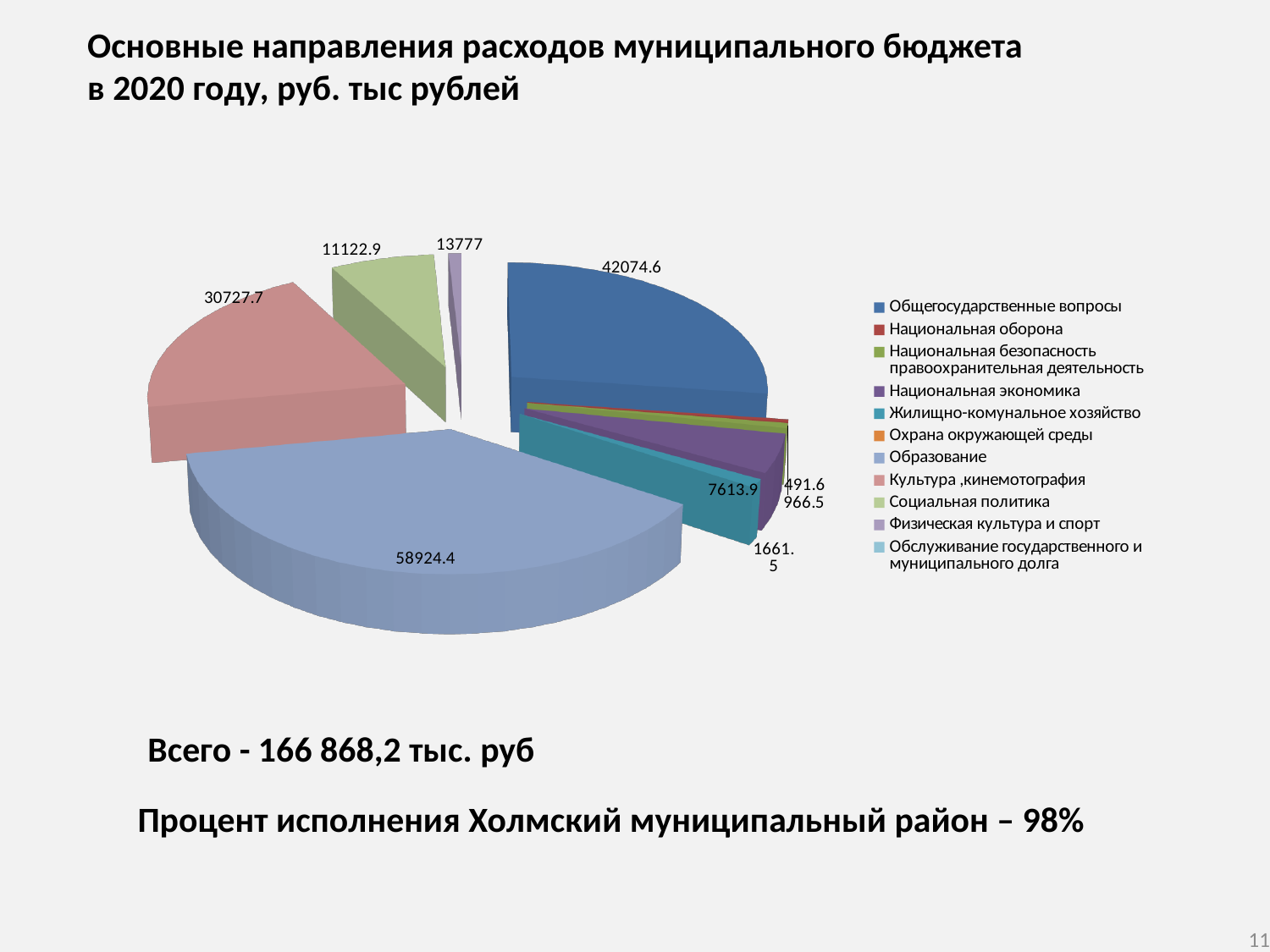
What is the value for Образование? 58924.4 What is the difference between Общегосударственные вопросы and Культура, кинемотография? 11346.9 Which is larger, Образование or Общегосударственные вопросы? Образование What is the value for Общегосударственные вопросы? 42074.6 Which is larger, Культура, кинемотография or Социальная политика? Культура, кинемотография What is the value for Культура, кинемотография? 30727.7 What is the value for Социальная политика? 11122.9 What type of chart is shown on the slide? Pie chart What is the difference between Образование and Общегосударственные вопросы? 16849.8 How many categories does the legend list? 11 Which category has the largest slice of the pie? Образование What total expenditure amount is stated below the chart? 166 868,2 тыс. руб